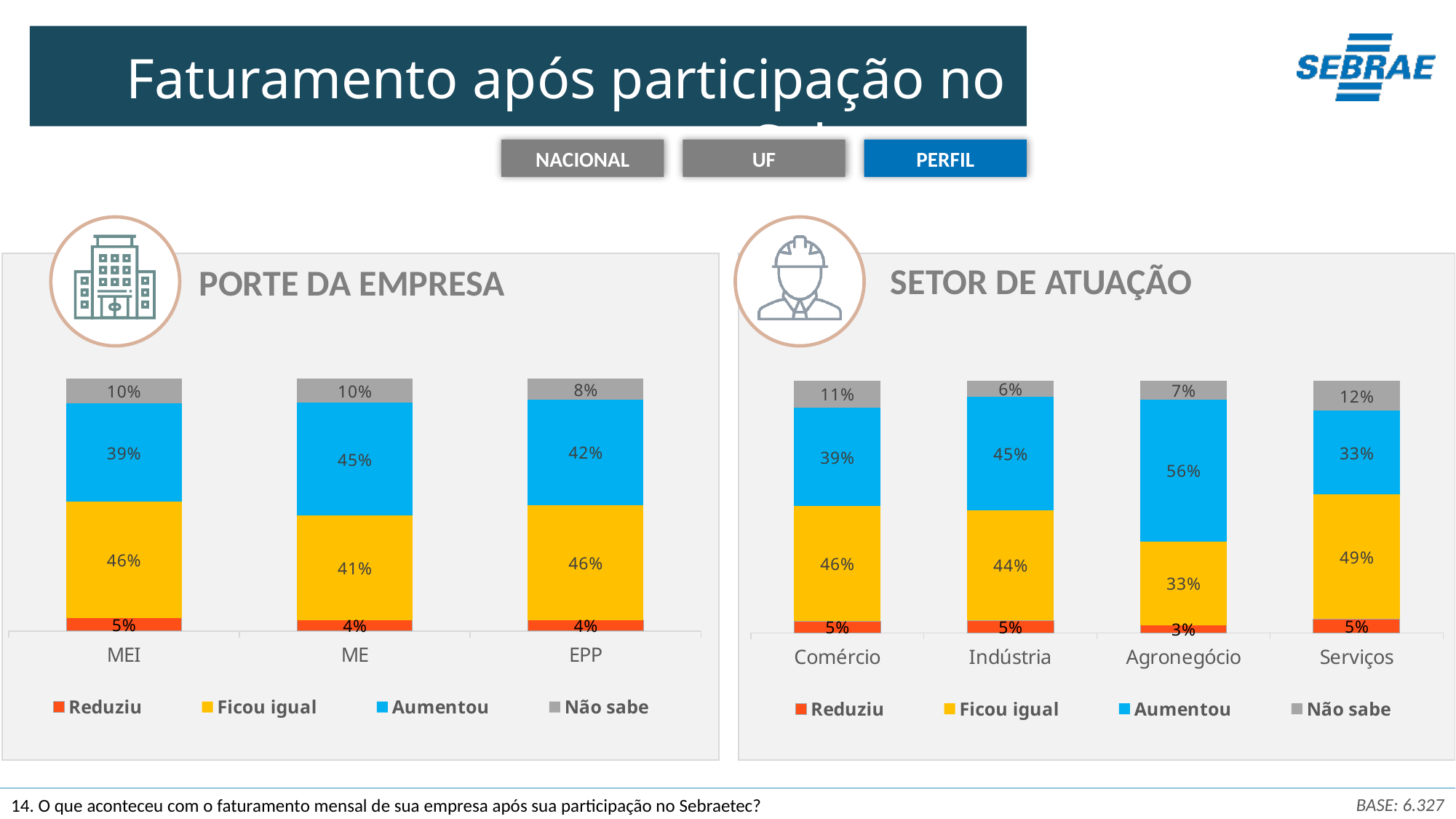
How many categories are shown on the x axis of the SETOR DE ATUAÇÃO chart? 4 In the SETOR DE ATUAÇÃO chart, what is the difference between the Ficou igual values for Serviços and Agronegócio? 16% In the PORTE DA EMPRESA chart, what is the total of the stacked bar for MEI? 100% In the SETOR DE ATUAÇÃO chart, which category has the highest Aumentou value? Agronegócio In the PORTE DA EMPRESA chart, what is the difference between the Aumentou values for ME and MEI? 6% Which legend entry in the SETOR DE ATUAÇÃO chart is shown in blue? Aumentou How many series does the legend of the PORTE DA EMPRESA chart list? 4 In the SETOR DE ATUAÇÃO chart, what is the Ficou igual value for Serviços? 49% What kind of chart is the PORTE DA EMPRESA chart? Stacked bar chart In the PORTE DA EMPRESA chart, what is the Aumentou value for ME? 45% In the SETOR DE ATUAÇÃO chart, which is larger: the Não sabe value for Serviços or for Indústria? Serviços In the SETOR DE ATUAÇÃO chart, which category has the lowest Reduziu value? Agronegócio